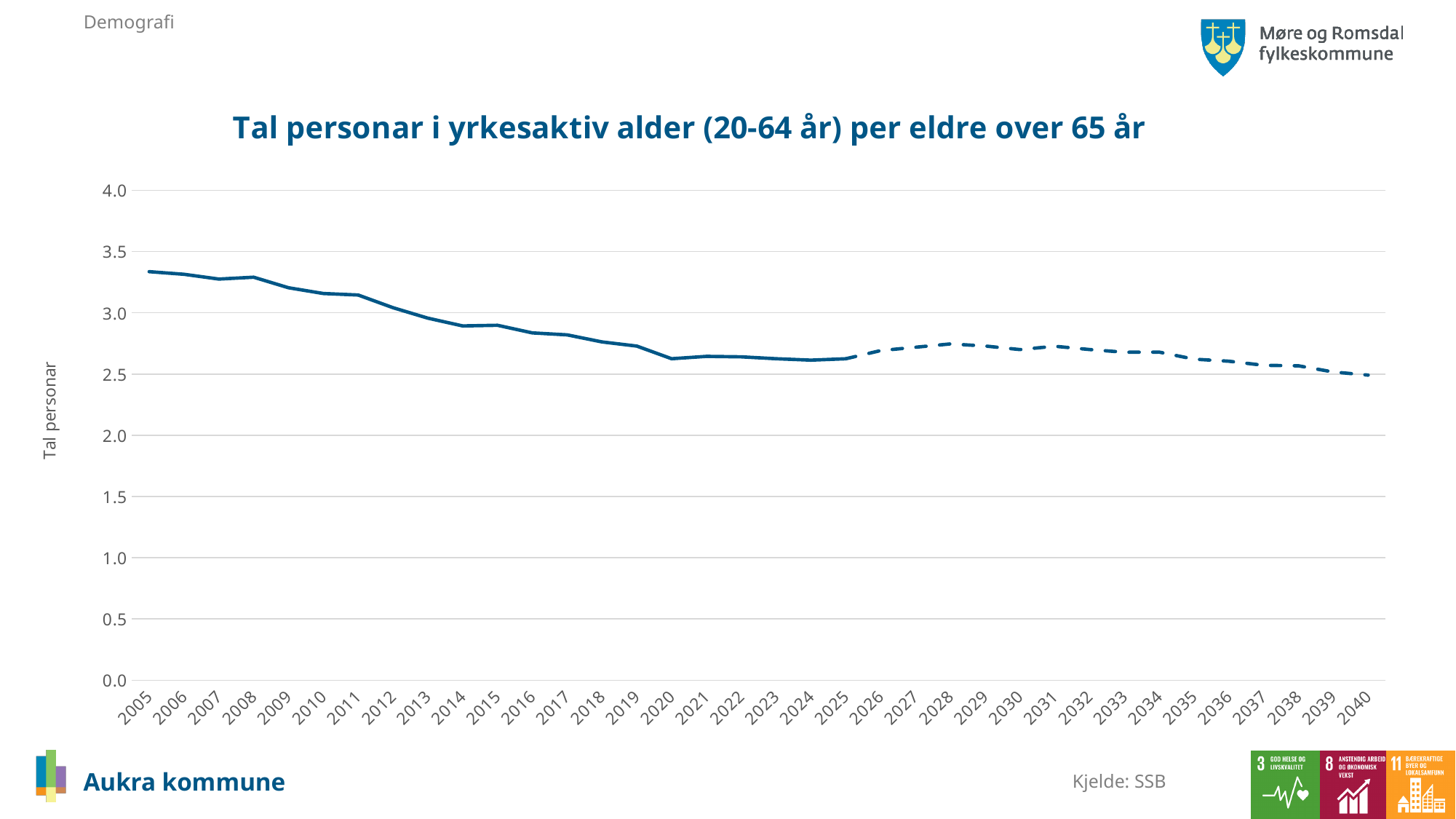
Which year has the lowest value on the chart? 2040 Is the value for 2040 greater or less than 3.0? less Is the value for 2028 greater or less than 2.5? greater What is the label on the vertical axis of the chart? Tal personar Is the value for 2020 greater or less than 3.0? less What kind of chart is shown on the slide? line chart Which year has the larger value, 2011 or 2020? 2011 Which year has the larger value, 2005 or 2040? 2005 Do the values generally rise or fall from 2005 to 2040? fall What is the title of the chart? Tal personar i yrkesaktiv alder (20-64 år) per eldre over 65 år How many years are shown along the x axis of the chart? 36